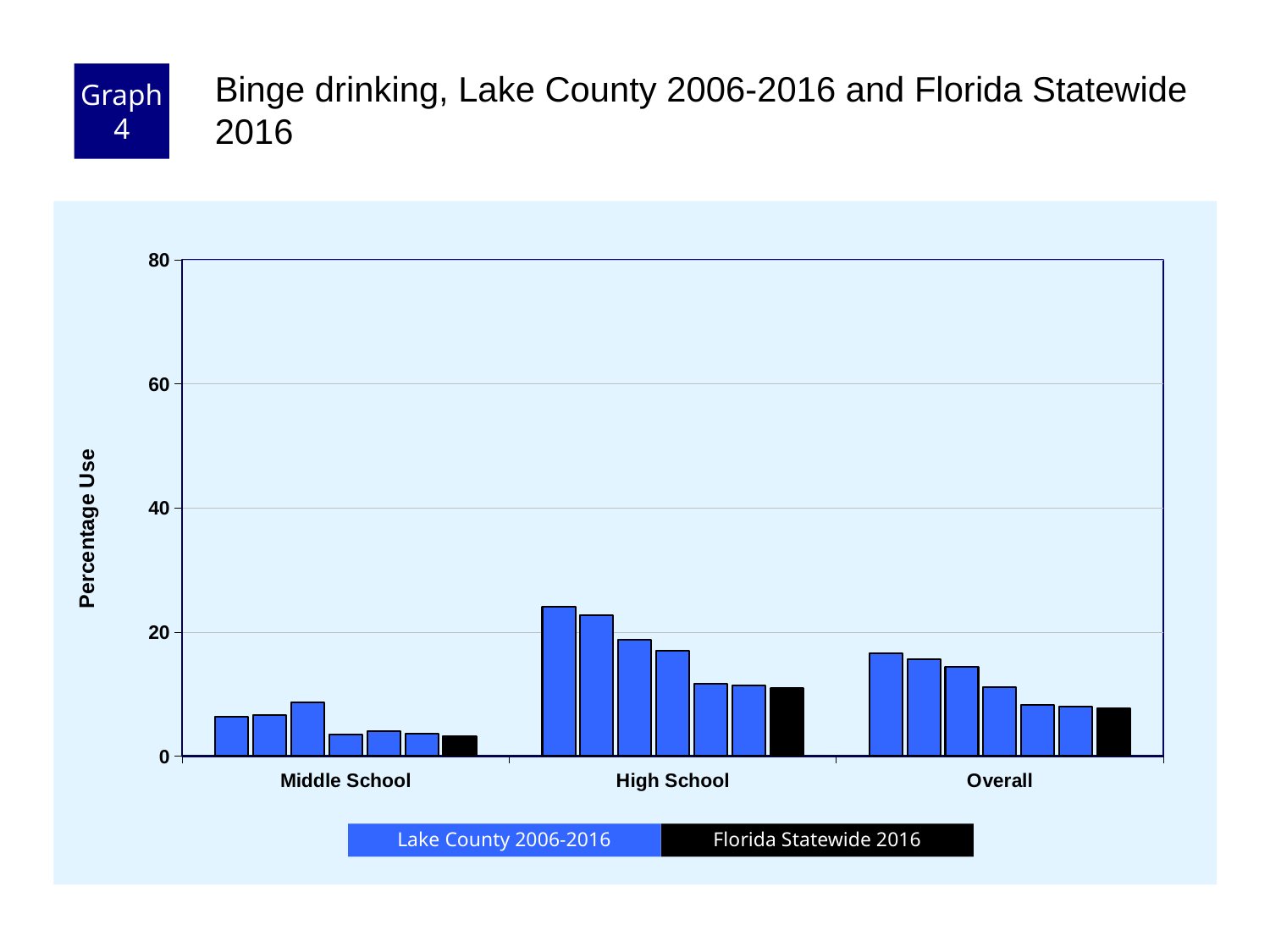
How many categories are shown on the x axis? 3 Is the value of the tallest High School bar greater or less than 20? greater Which category has the lowest bars overall? Middle School What is the title of the y axis? Percentage Use How many series does the legend list? 2 Which colour represents Florida Statewide 2016 in the legend? black Which category has the highest bars overall? High School What kind of chart is shown on the slide? bar chart Is the Florida Statewide 2016 value for Overall greater or less than 20? less Is the value of the tallest Middle School bar greater or less than 20? less Which is larger, the Florida Statewide 2016 bar for High School or the Florida Statewide 2016 bar for Middle School? High School Do the Lake County 2006-2016 bars for High School rise or fall from left to right? fall